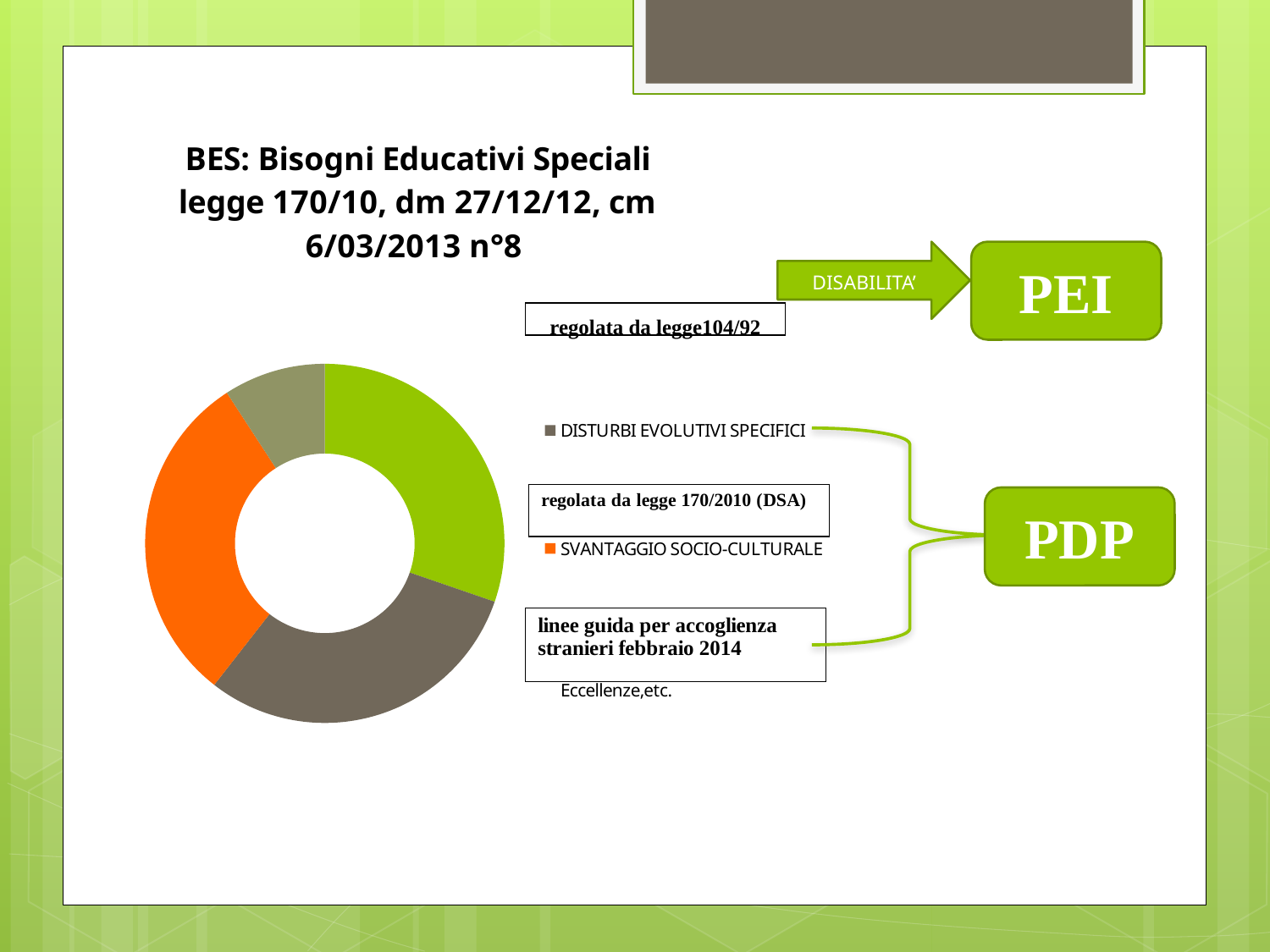
How many slices does the doughnut chart have? 4 What kind of chart is shown on the slide? Doughnut (pie) chart Which colour is used for the DISTURBI EVOLUTIVI SPECIFICI slice in the doughnut chart? Dark grey-brown Which slice is larger in the doughnut chart: DISTURBI EVOLUTIVI SPECIFICI or Eccellenze,etc.? DISTURBI EVOLUTIVI SPECIFICI Which slice of the doughnut chart is the smallest? Eccellenze,etc. Which colour is used for the SVANTAGGIO SOCIO-CULTURALE slice in the doughnut chart? Orange Which slice is larger in the doughnut chart: SVANTAGGIO SOCIO-CULTURALE or Eccellenze,etc.? SVANTAGGIO SOCIO-CULTURALE